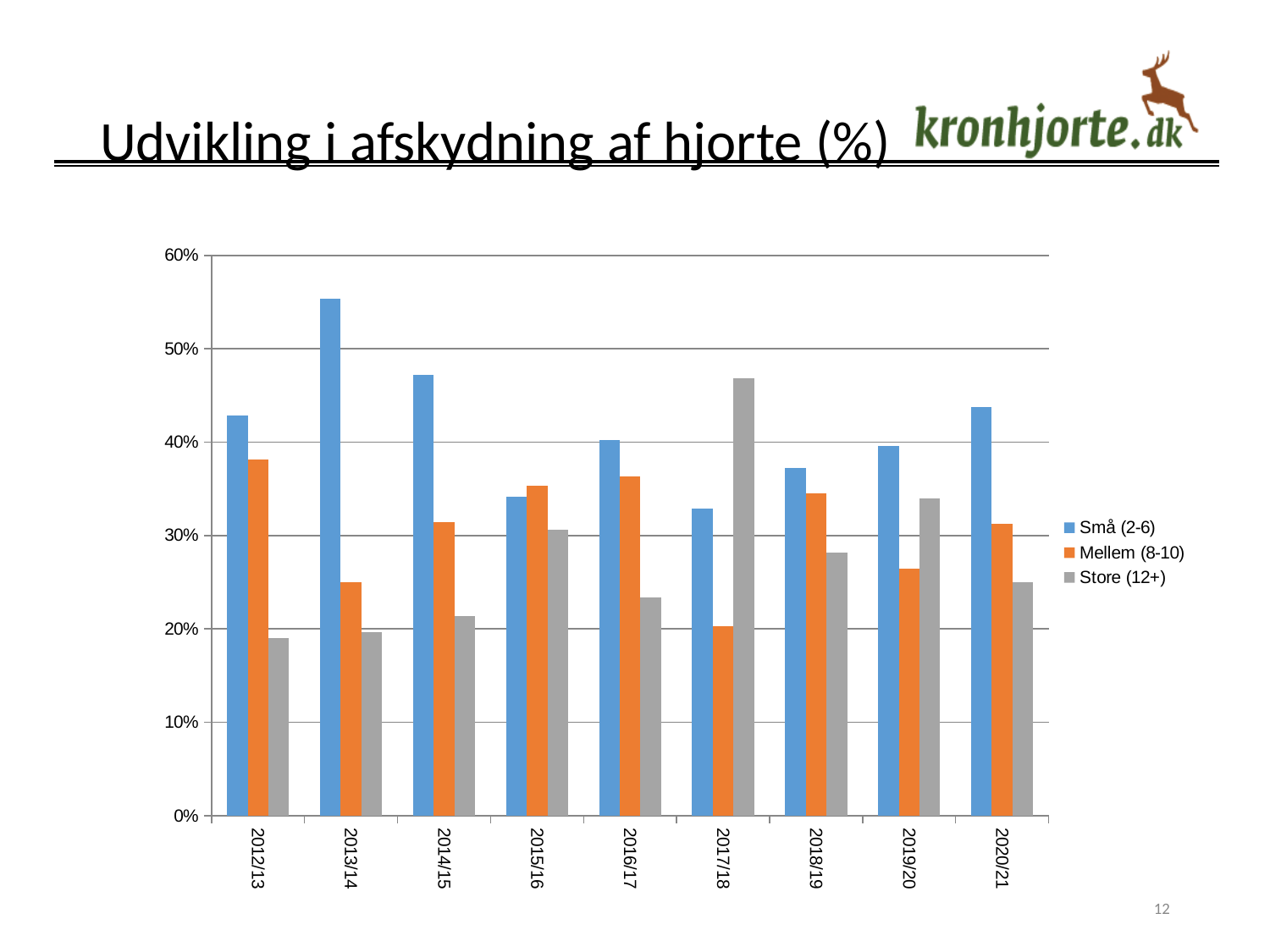
Is the value for Små (2-6) in 2013/14 greater or less than 50%? greater What are the three series listed in the legend? Små (2-6), Mellem (8-10), Store (12+) What kind of chart is shown on the slide? bar chart Is the value for Mellem (8-10) in 2016/17 greater or less than 30%? greater In which season is the value for Store (12+) highest? 2017/18 In 2017/18, which is larger: Små (2-6) or Store (12+)? Store (12+) How many series does the legend list? 3 Is the value for Store (12+) in 2012/13 greater or less than 20%? less In which season is the value for Mellem (8-10) lowest? 2017/18 In 2013/14, which is larger: Små (2-6) or Mellem (8-10)? Små (2-6) In which season is the value for Små (2-6) highest? 2013/14 How many seasons (categories) are shown on the x axis? 9